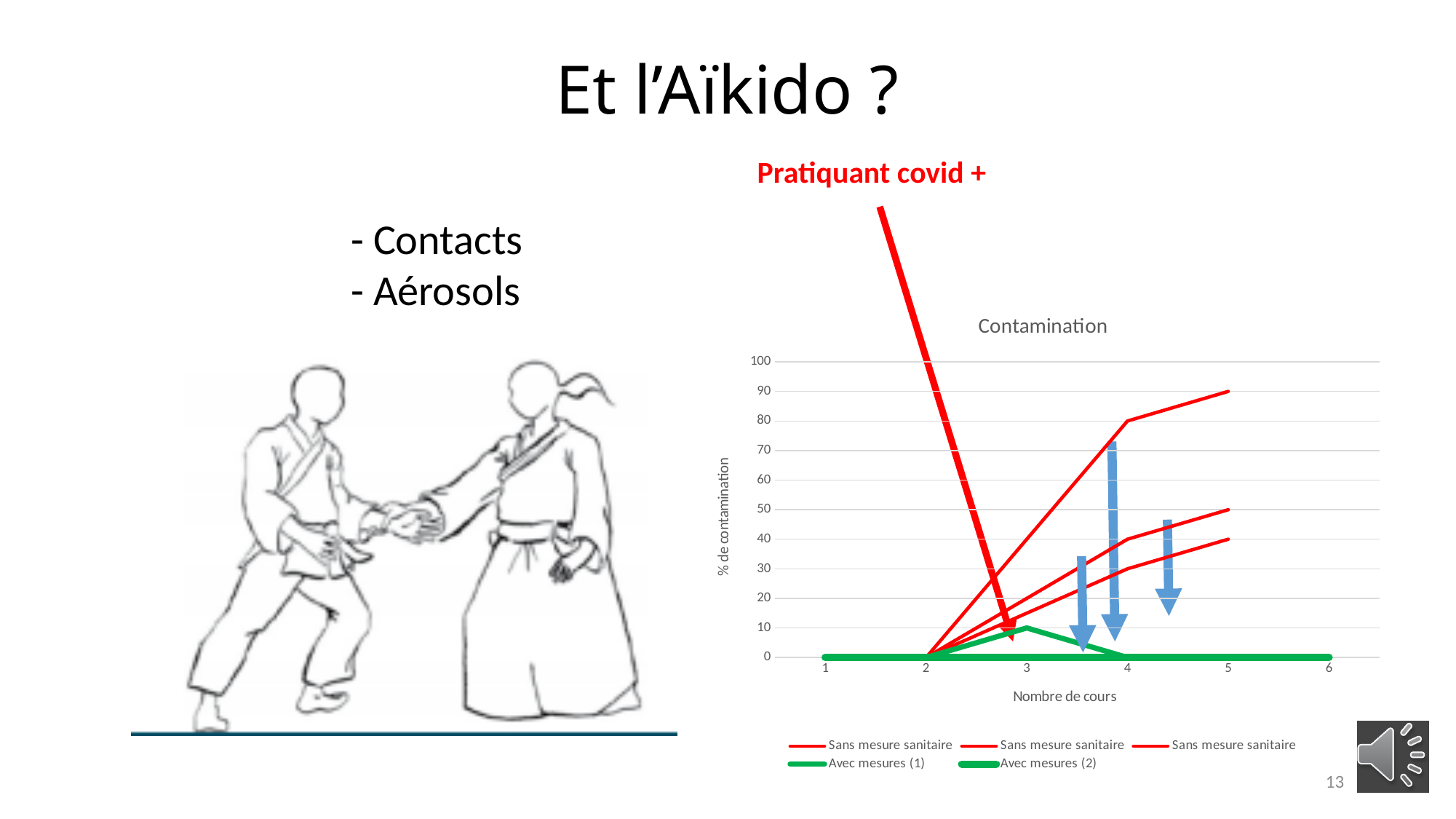
What value does the highest red 'Sans mesure sanitaire' line reach at cours 5? 90 How many series does the chart legend list? 5 Is the value of the highest red 'Sans mesure sanitaire' line at cours 5 greater or less than 80? greater Is the value of the lowest red 'Sans mesure sanitaire' line at cours 4 greater or less than 20? greater What type of chart is shown on the slide? line chart How many points are shown on the x axis of the chart? 6 Do the red 'Sans mesure sanitaire' lines rise or fall as the number of cours increases from 2 to 5? rise What is the title of the chart? Contamination What is the label of the x axis of the chart? Nombre de cours Is the value of the green 'Avec mesures' lines at cours 6 greater or less than 10? less At cours 5, which is higher: the top red 'Sans mesure sanitaire' line or the green 'Avec mesures (1)' line? Sans mesure sanitaire